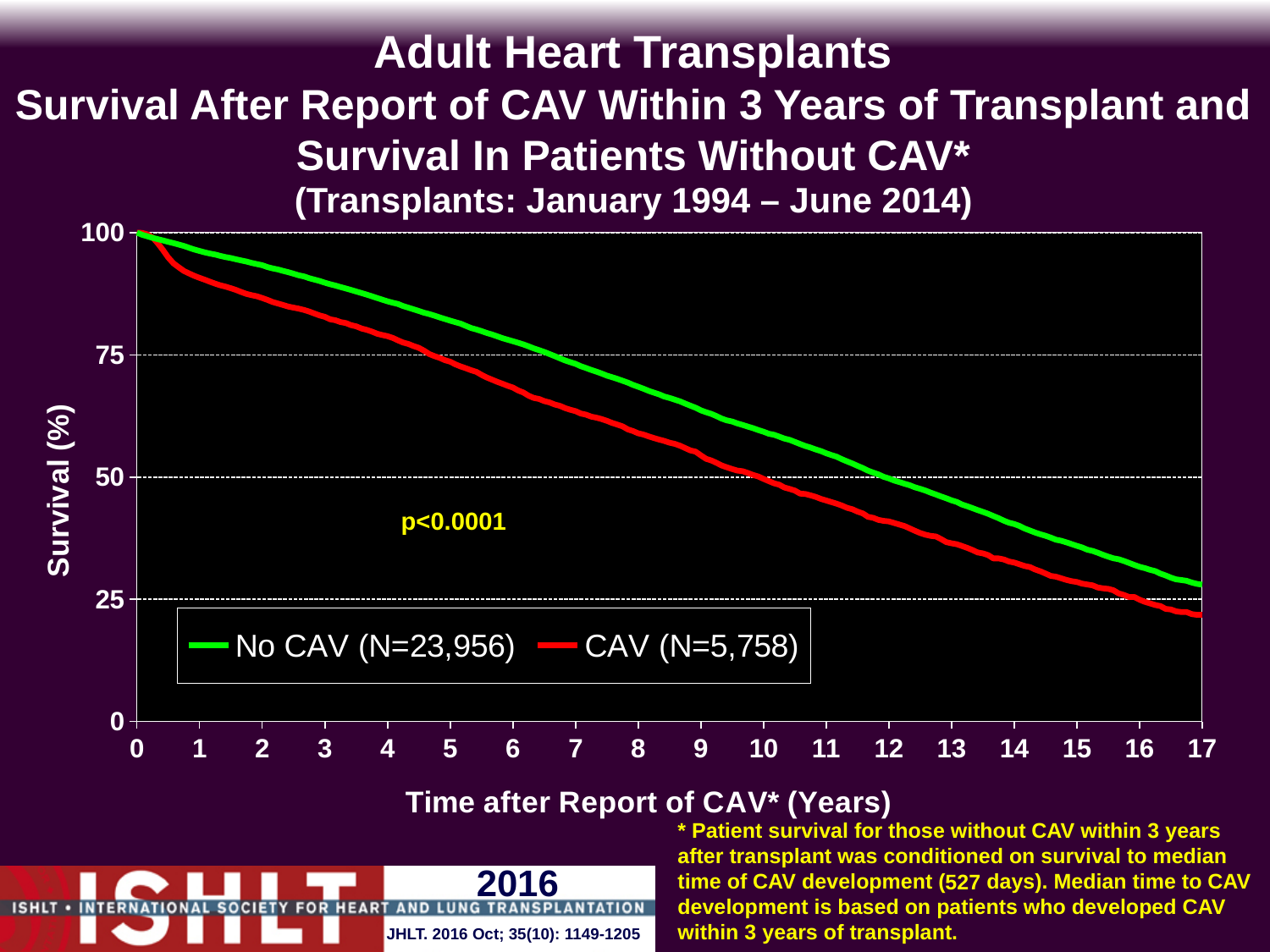
What p-value is printed on the chart? p<0.0001 Is the survival value for No CAV at 10 years greater or less than 50? greater Do the survival curves rise or fall as time after report of CAV increases? fall What is the number of patients (N) in the No CAV group according to the legend? 23,956 Is the survival value for CAV at 8 years greater or less than 50? greater Is the survival value for No CAV at 5 years greater or less than 75? greater At 10 years, which series has the higher survival, No CAV or CAV? No CAV What kind of chart is shown on the slide? line chart How many series does the legend list? 2